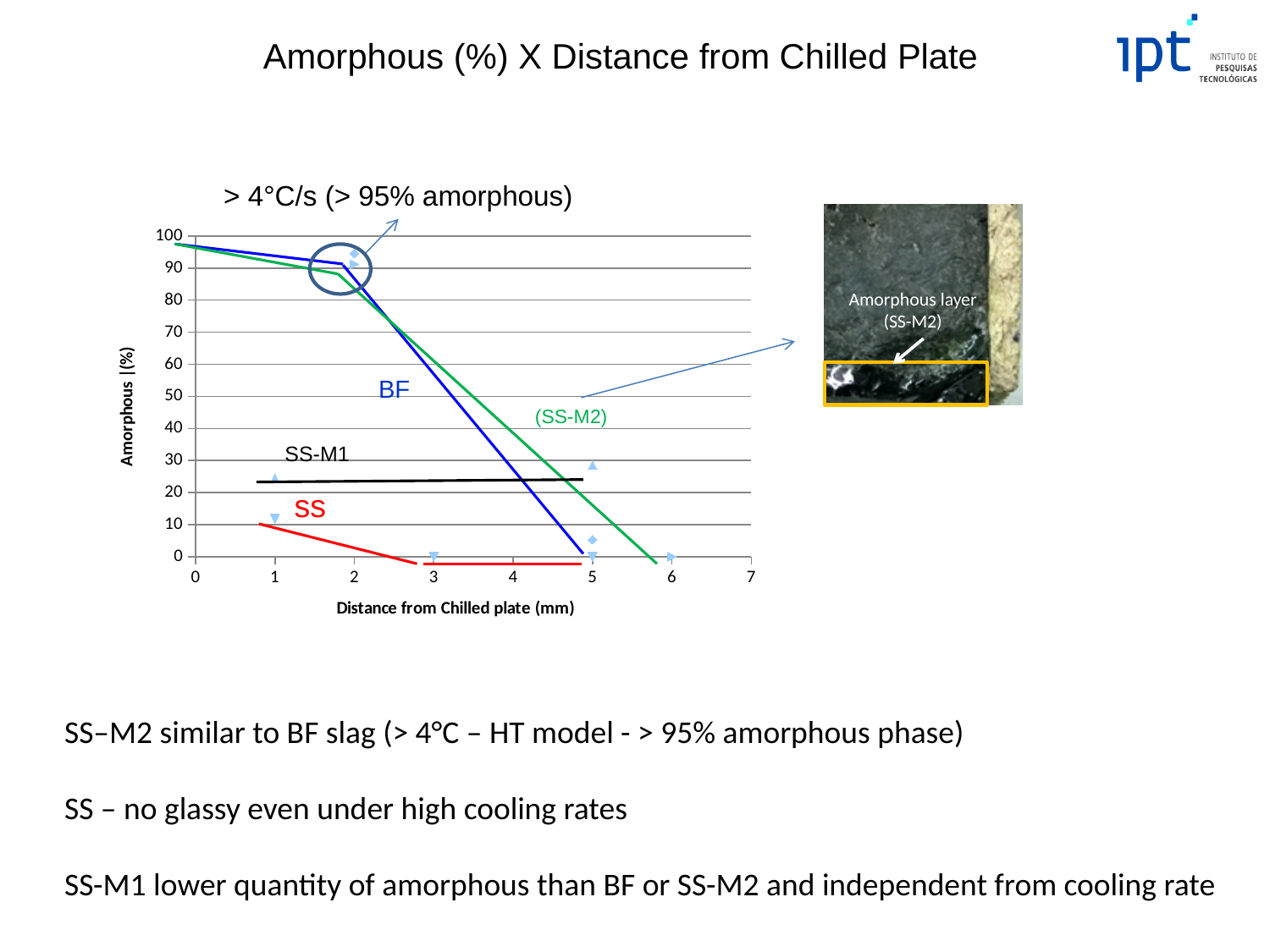
What kind of chart is shown on the slide? line chart Is the SS-M1 value at 1 mm greater or less than 30? less Does the BF line rise or fall as distance from the chilled plate increases? fall What is the title of the x axis of the chart? Distance from Chilled plate (mm) Does the SS-M2 line rise or fall as distance from the chilled plate increases? fall What colour is the SS line on the chart? red How many series (slag types) are plotted on the chart? 4 Is the SS value at 3 mm greater or less than 10? less